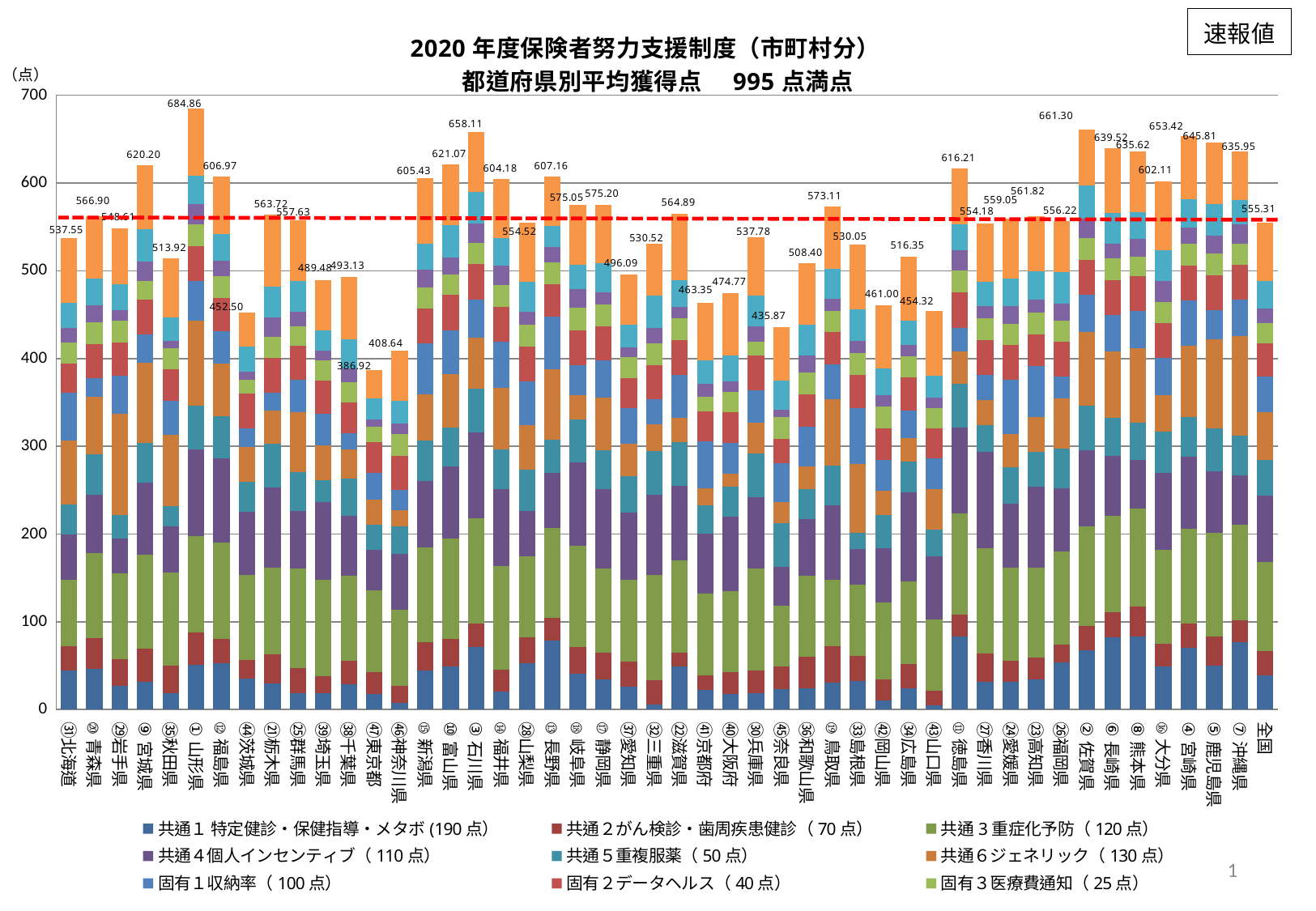
Which prefecture has the lowest total score? 東京都 How many series does the legend list? 9 What is the total value shown for 全国? 555.31 What kind of chart is shown on the slide? stacked bar chart What is the total value shown for 東京都? 386.92 Is the total for 神奈川県 greater or less than 500? less What is the difference between the totals for 山形県 and 東京都? 297.94 What is the maximum possible score stated in the chart title? 995点 Which prefecture has the highest total score? 山形県 Which has a higher total, 佐賀県 or 石川県? 佐賀県 What is the total value shown for 山形県? 684.86 What is the difference between the totals for 宮崎県 and 鹿児島県? 7.61